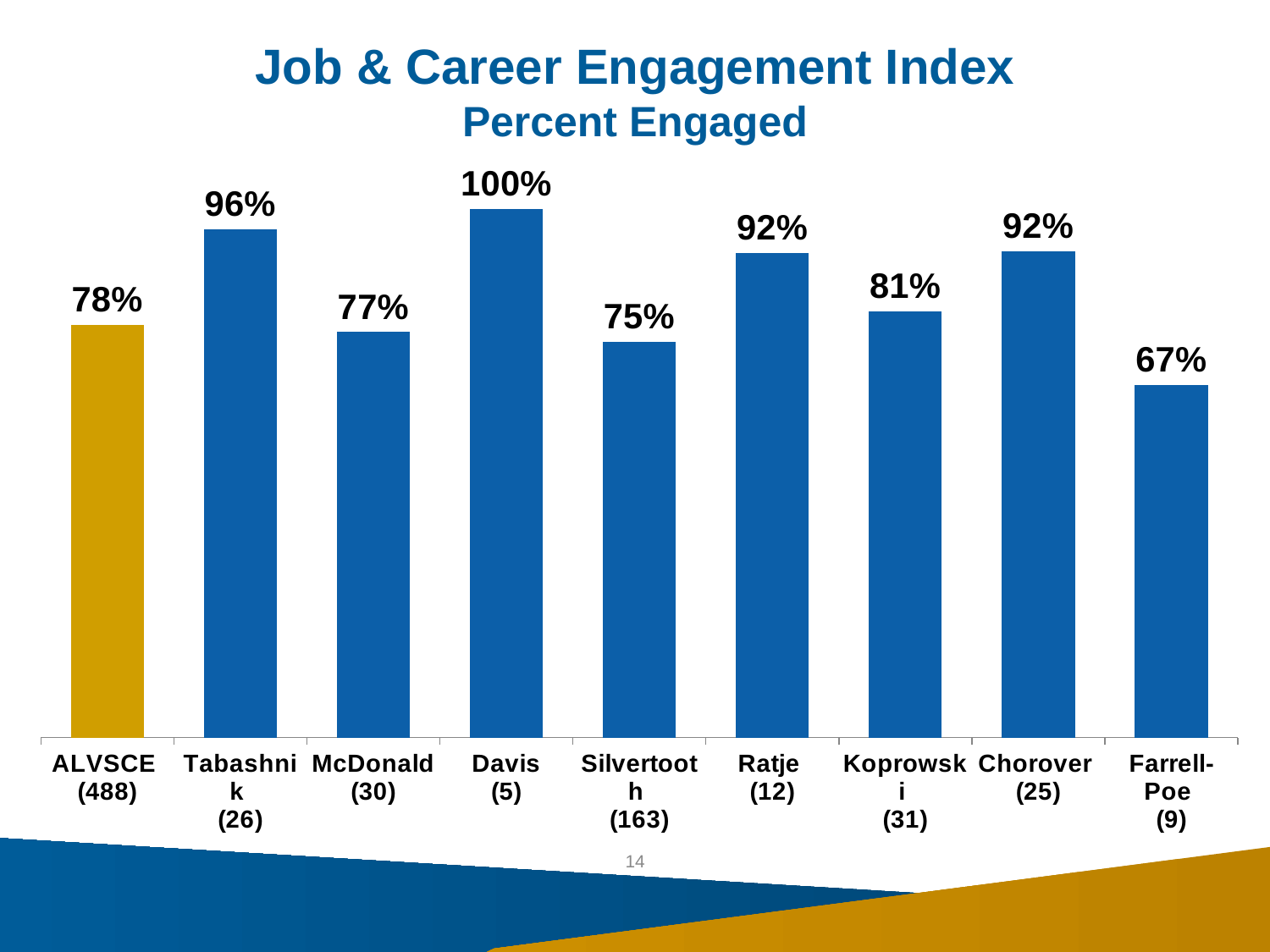
What is the percent engaged for ALVSCE (488)? 78% What is the percent engaged for Silvertooth (163)? 75% What is the percent engaged for Koprowski (31)? 81% Which has a higher percent engaged, ALVSCE (488) or Silvertooth (163)? ALVSCE (488) What kind of chart is shown on the slide? Bar chart What is the difference in percent engaged between Tabashnik (26) and McDonald (30)? 19% Which bar is shown in a different colour (gold) from the others? ALVSCE (488) Which category has the lowest percent engaged? Farrell-Poe (9) How many categories are shown in the chart? 9 Which category has the highest percent engaged? Davis (5) Which has a higher percent engaged, Ratje (12) or Koprowski (31)? Ratje (12) What is the difference in percent engaged between Davis (5) and Farrell-Poe (9)? 33%